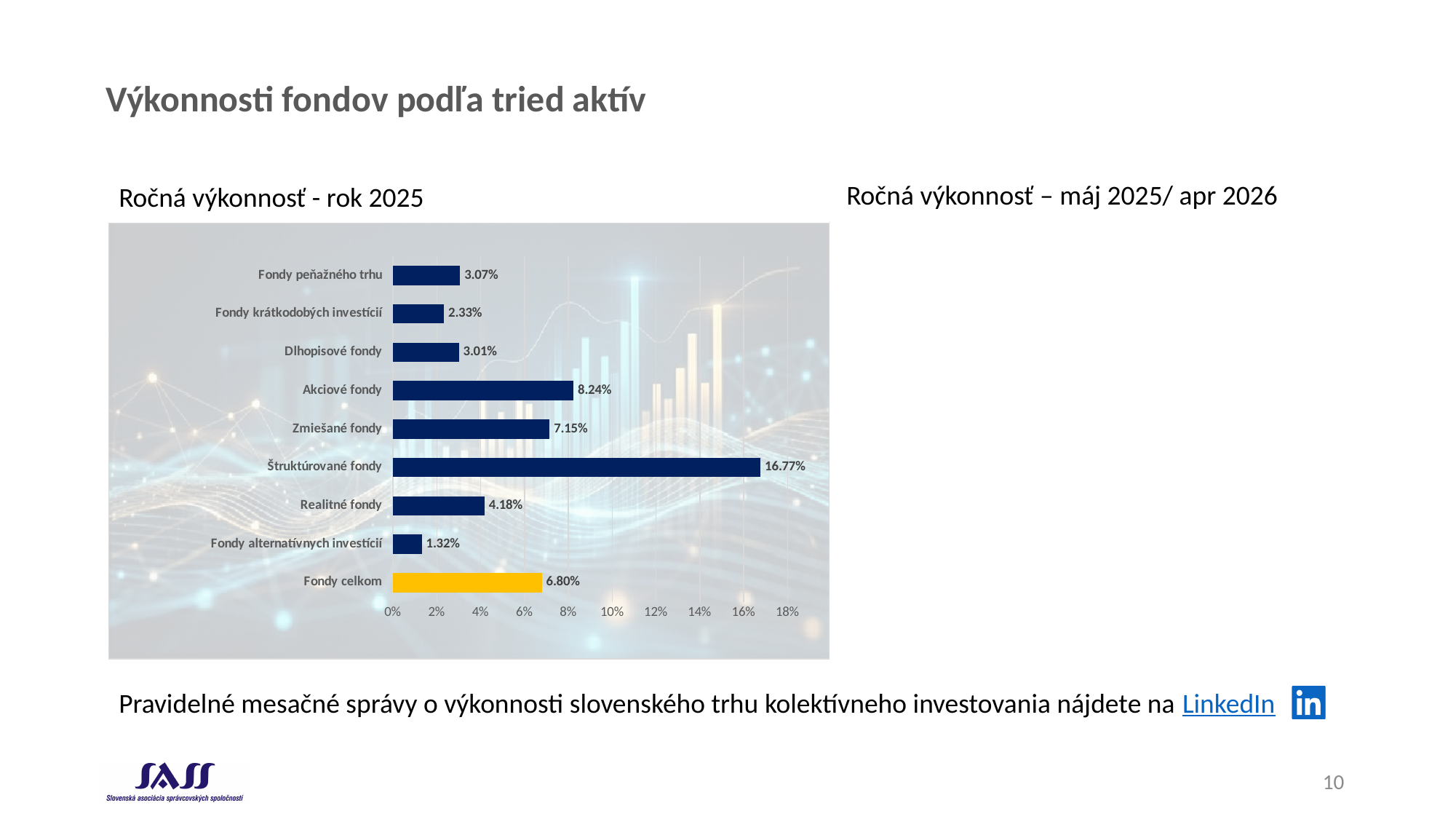
Which category has the highest value in the chart? Štruktúrované fondy What is the value for Fondy krátkodobých investícií in the chart? 2.33% What is the value for Fondy celkom in the chart? 6.80% What kind of chart is shown on the slide? Bar chart What is the title of the chart on the slide? Ročná výkonnosť - rok 2025 Is the value for Štruktúrované fondy greater or less than 14%? greater Which category has the lowest value in the chart? Fondy alternatívnych investícií What is the value for Realitné fondy in the chart? 4.18% Which is larger, the value for Akciové fondy or the value for Zmiešané fondy? Akciové fondy What is the difference between the values for Akciové fondy and Zmiešané fondy? 1.09 percentage points What is the value for Štruktúrované fondy in the chart? 16.77% How many categories are shown in the chart? 9